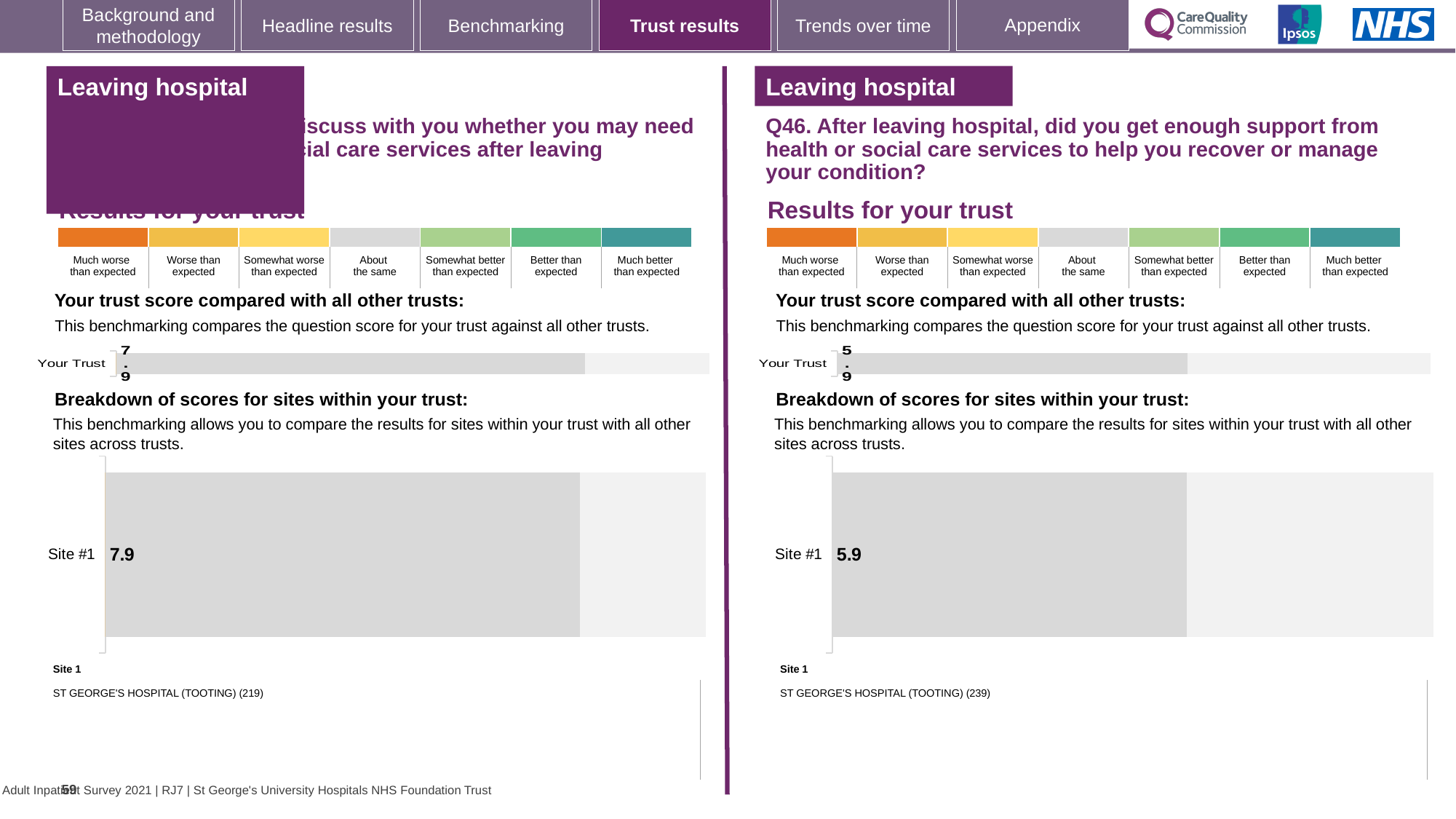
What is the difference between the 'Your Trust' score on the left-hand chart (7.9) and the 'Your Trust' score on the right-hand Q46 chart (5.9)? 2.0 How many sites are shown in the right-hand 'Breakdown of scores for sites within your trust' chart for Q46? 1 On the left-hand chart, what is the score shown for 'Your Trust'? 7.9 According to the site key below the left-hand breakdown chart, which hospital is Site 1? ST GEORGE'S HOSPITAL (TOOTING) Which is higher: the 'Your Trust' score on the left-hand chart or the 'Your Trust' score on the right-hand Q46 chart? The left-hand chart (7.9) What is the label of the single bar in the left-hand breakdown chart? Site #1 What type of chart is used to show the Site #1 score on the right-hand side of the slide? Bar chart On the left-hand 'Breakdown of scores for sites within your trust' chart, what is the score for Site #1? 7.9 How many sites are shown in the left-hand 'Breakdown of scores for sites within your trust' chart? 1 Which is higher: the Site #1 score on the left-hand chart or the Site #1 score on the right-hand Q46 chart? The left-hand chart (7.9) On the right-hand chart for Q46, what is the score shown for 'Your Trust'? 5.9 On the right-hand 'Breakdown of scores for sites within your trust' chart for Q46, what is the score for Site #1? 5.9